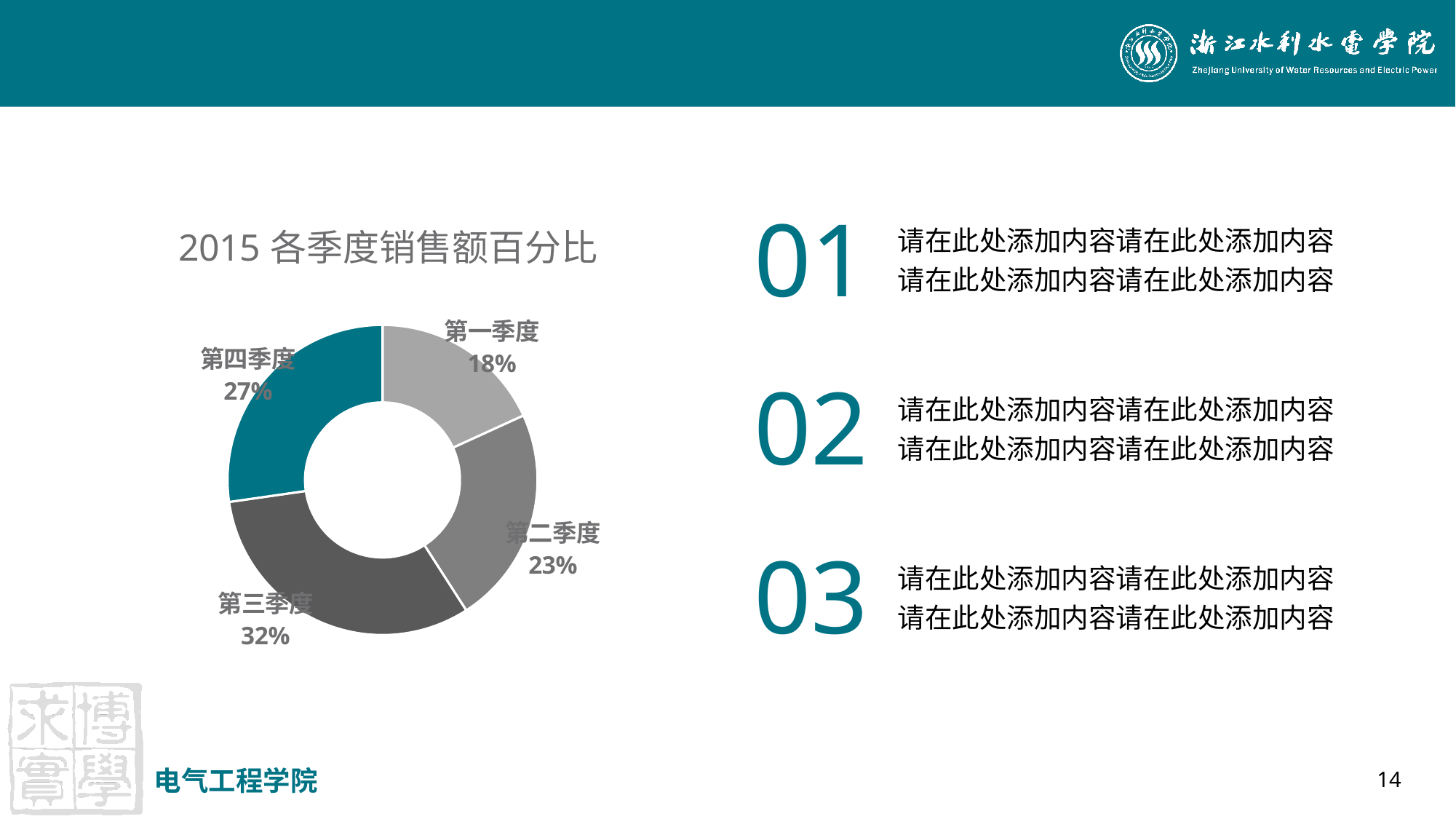
What kind of chart is shown on the slide? doughnut (pie) chart What percentage is shown for 第一季度? 18% What percentage is shown for 第三季度? 32% Which quarter has the smallest share? 第一季度 Which quarter has the largest share? 第三季度 What percentage is shown for 第二季度? 23% What percentage is shown for 第四季度? 27% Which slice is coloured teal? 第四季度 What is the difference in percentage points between 第三季度 and 第一季度? 14 Which is larger, the share for 第二季度 or 第四季度? 第四季度 What is the title of the chart? 2015 各季度销售额百分比 How many slices does the chart have? 4